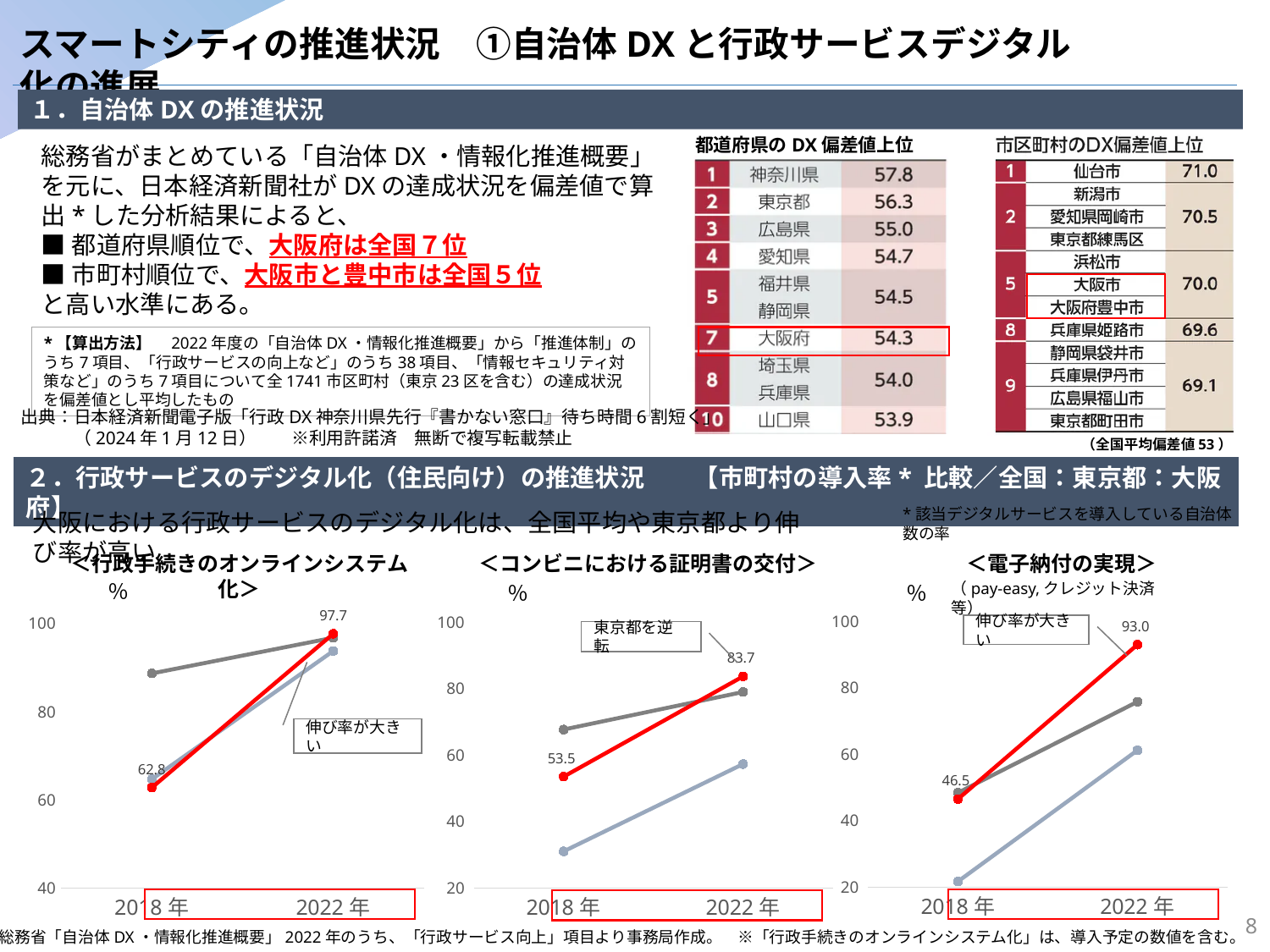
In the 電子納付の実現 chart, do the lines rise or fall from 2018年 to 2022年? rise Which of the three line charts has the highest labelled red-line value for 2022年? 行政手続きのオンラインシステム化 (97.7) In the 行政手続きのオンラインシステム化 chart, what value is labelled on the red line for 2018年? 62.8 In the 電子納付の実現 chart, what value is labelled on the red line for 2022年? 93.0 How many lines are plotted in the 行政手続きのオンラインシステム化 chart? 3 How many x-axis points (years) does the コンビニにおける証明書の交付 chart show? 2 In the コンビニにおける証明書の交付 chart, what value is labelled on the red line for 2018年? 53.5 What kind of chart is the 行政手続きのオンラインシステム化 chart? line chart In the コンビニにおける証明書の交付 chart, what is the difference between the red line's labelled values for 2022年 (83.7) and 2018年 (53.5)? 30.2 In the 電子納付の実現 chart, by how much does the red line's labelled value increase from 2018年 (46.5) to 2022年 (93.0)? 46.5 In the 電子納付の実現 chart, is the 2018年 value of the light blue line greater or less than 40? less In the 行政手続きのオンラインシステム化 chart, what value is labelled on the red line for 2022年? 97.7